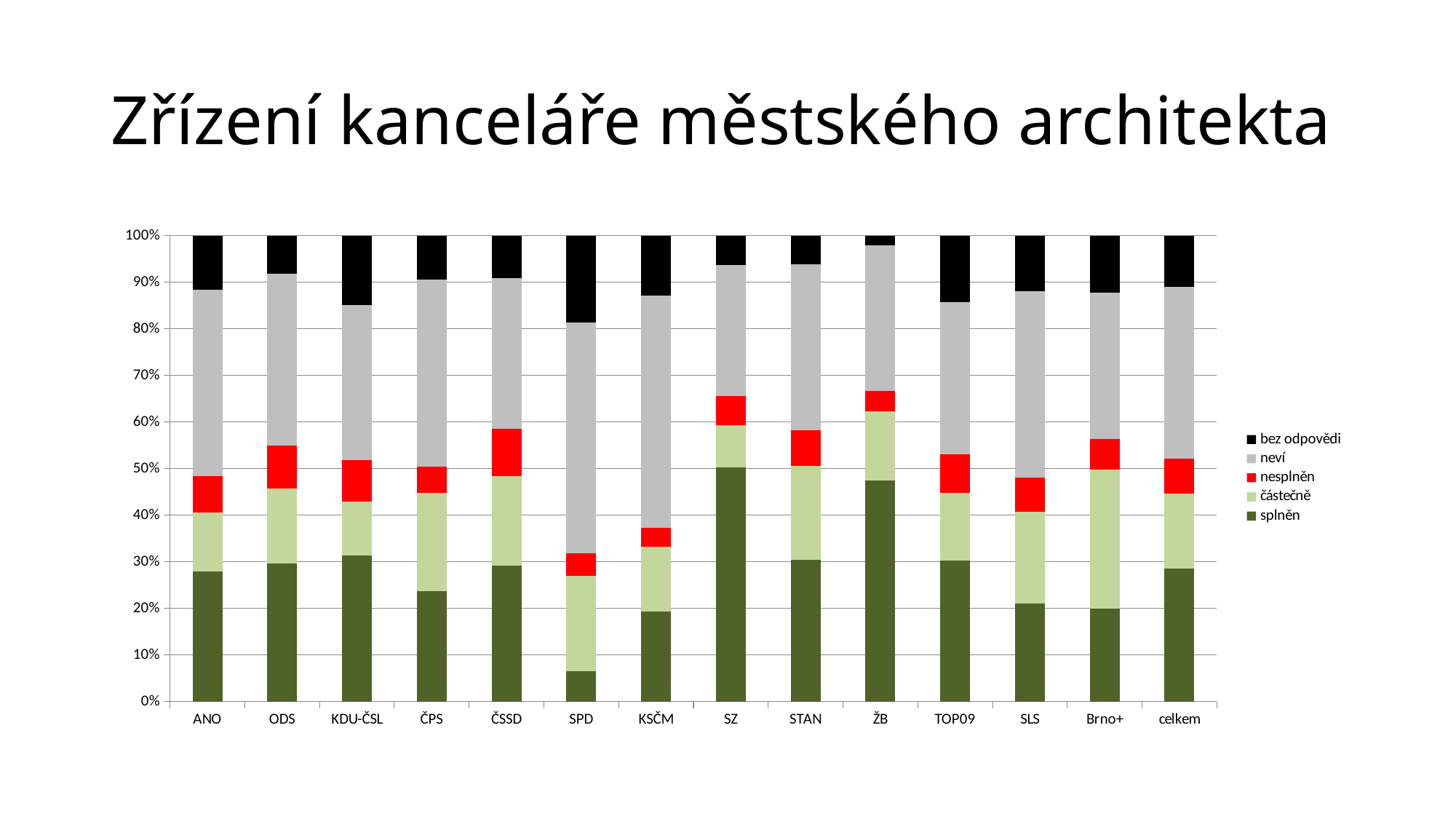
How many series does the chart's legend list? 5 What kind of chart is shown on the slide? stacked bar chart Which has a larger 'splněn' value, SZ or SPD? SZ Is the 'splněn' value for ŽB greater or less than 40%? greater Which category has the lowest value for the 'splněn' series? SPD Is the 'splněn' value for SPD greater or less than 10%? less Which series is shown in dark green in the chart? splněn What is the title of the slide? Zřízení kanceláře městského architekta Which category has the largest 'bez odpovědi' segment? SPD Which category has the highest value for the 'splněn' series? SZ Which category has the smallest 'bez odpovědi' segment? ŽB How many categories are shown along the x axis of the chart? 14